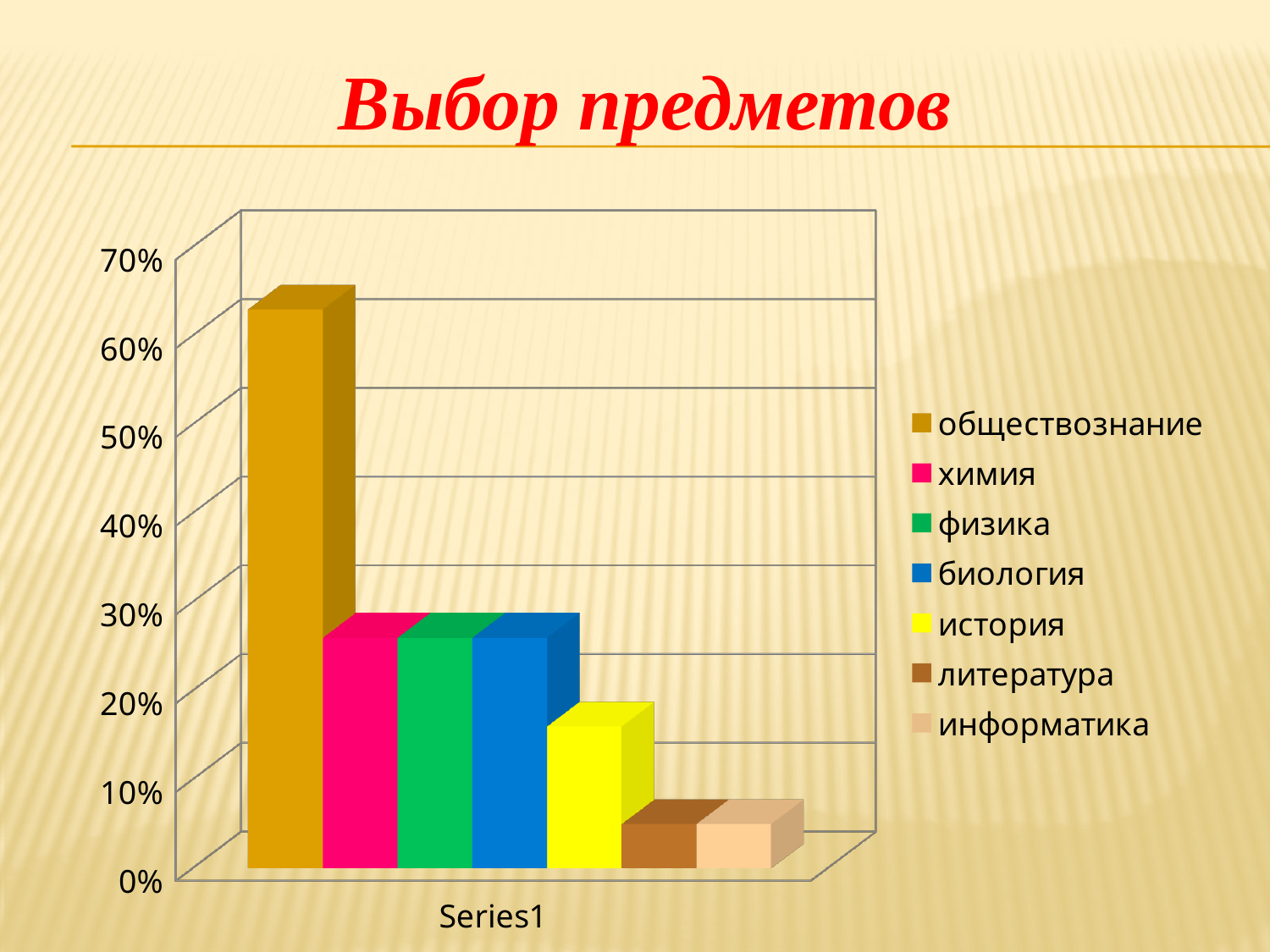
Is the value for история greater or less than 20%? less What is the title of the slide? Выбор предметов What kind of chart is shown on the slide? bar chart Is the value for химия greater or less than 30%? less Which subject has the highest value in the chart? обществознание Is the value for литература greater or less than 10%? less Which has a larger value, биология or история? биология How many subjects (categories) does the chart show? 7 What label is shown on the horizontal axis below the bars? Series1